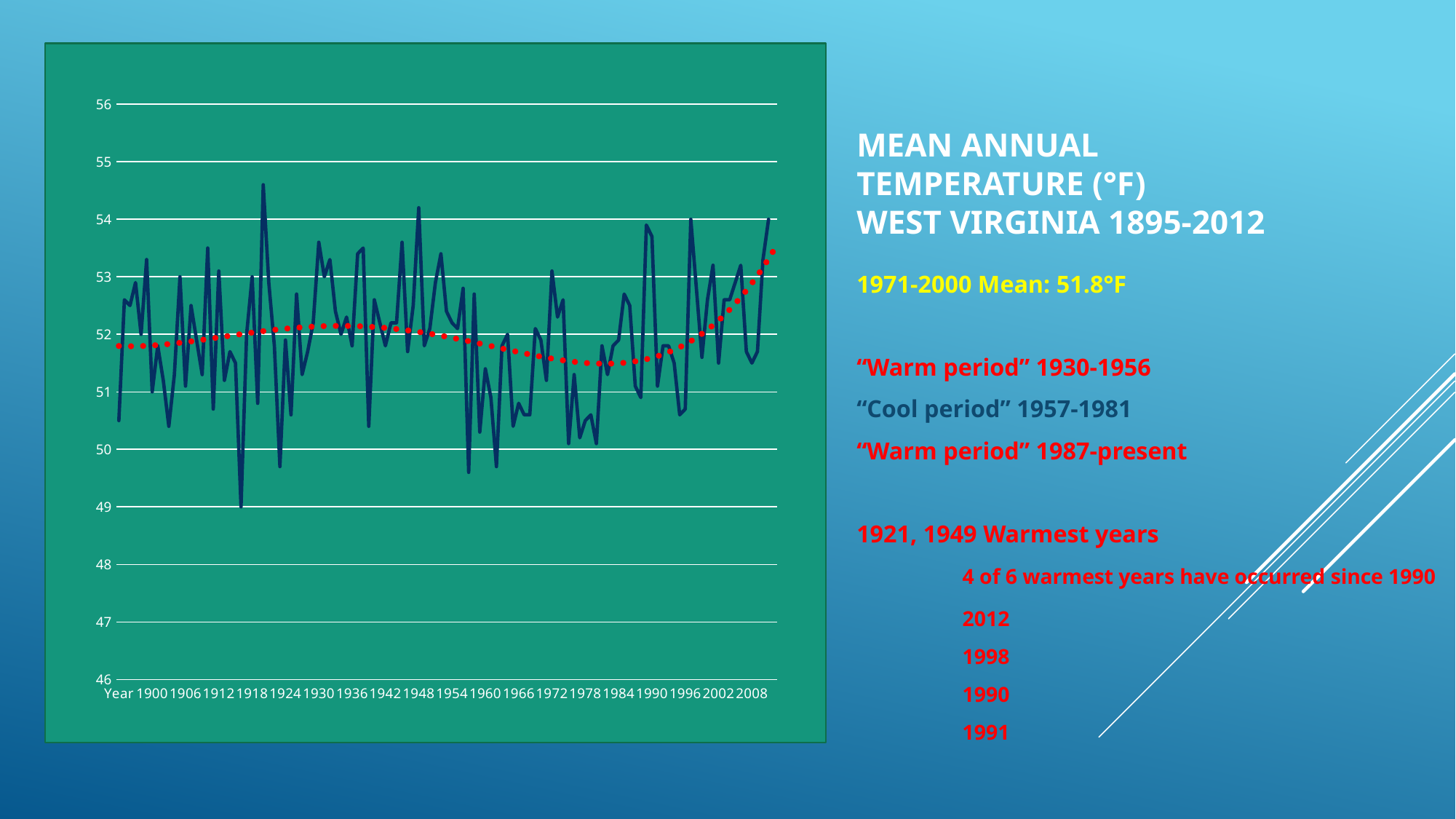
Does the dotted trend line rise or fall between 1956 and 1981? fall Does the dotted trend line rise or fall between 1990 and 2012? rise What kind of chart is shown on the slide? line chart What is the highest value shown on the vertical axis? 56 What is the last year label shown on the horizontal axis? 2008 Is the value for 2012 greater or less than 53? greater What is the first year label shown on the horizontal axis after "Year"? 1900 What is the lowest value shown on the vertical axis? 46 Is the lowest point on the line, around 1917, greater or less than 50? less